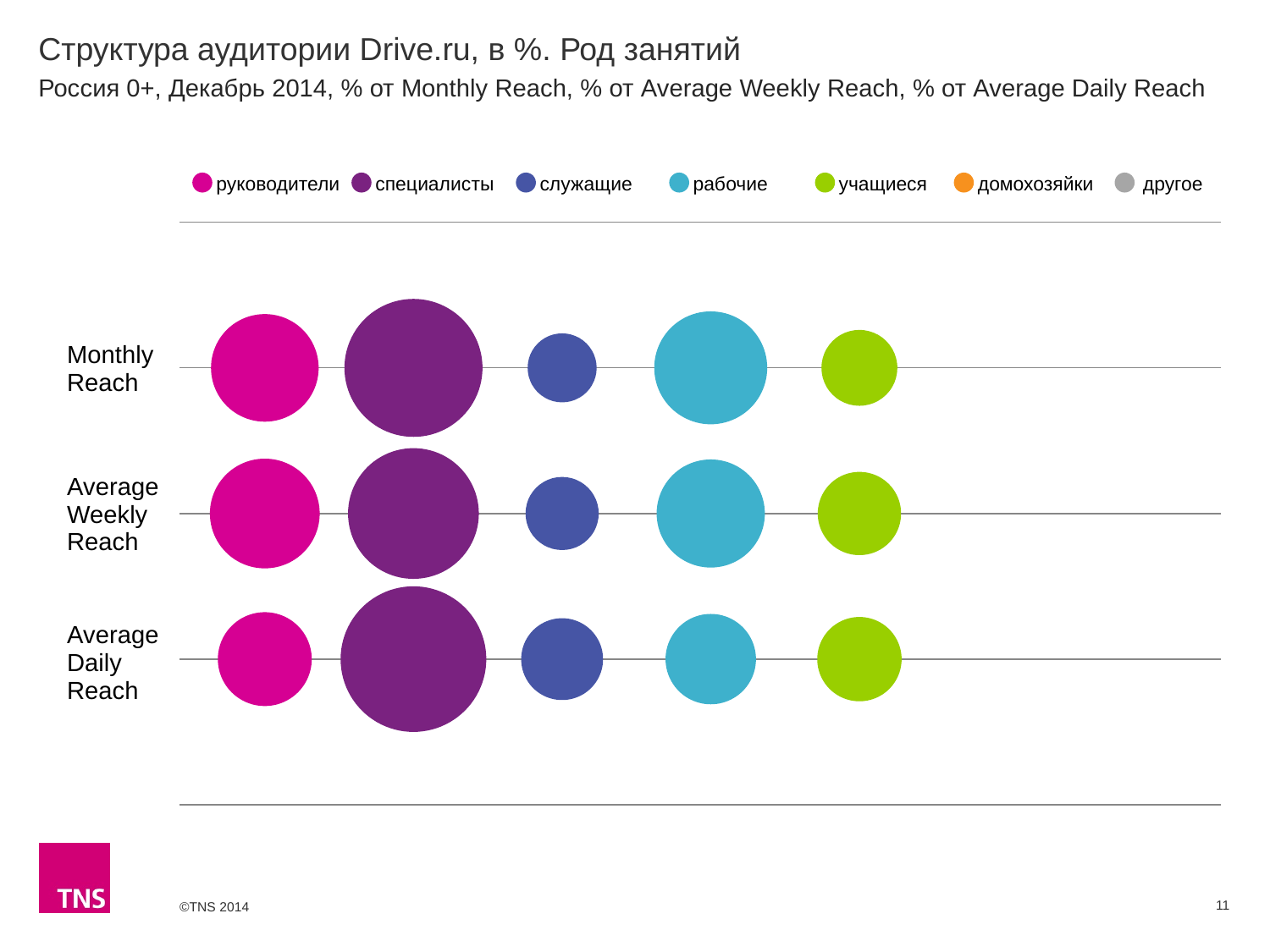
In the Average Daily Reach row, which bubble is larger: специалисты or учащиеся? специалисты What kind of chart is shown on the slide? bubble chart In the Monthly Reach row, which bubble is larger: рабочие or служащие? рабочие Which occupation group has the largest bubble in the Monthly Reach row? специалисты Which legend entry is shown in orange? домохозяйки How many series does the legend list? 7 In the Average Weekly Reach row, which bubble is larger: специалисты or руководители? специалисты How many reach categories (rows) are plotted on the chart? 3 Which occupation group has the largest bubble in the Average Daily Reach row? специалисты What is the title of the chart on the slide? Структура аудитории Drive.ru, в %. Род занятий